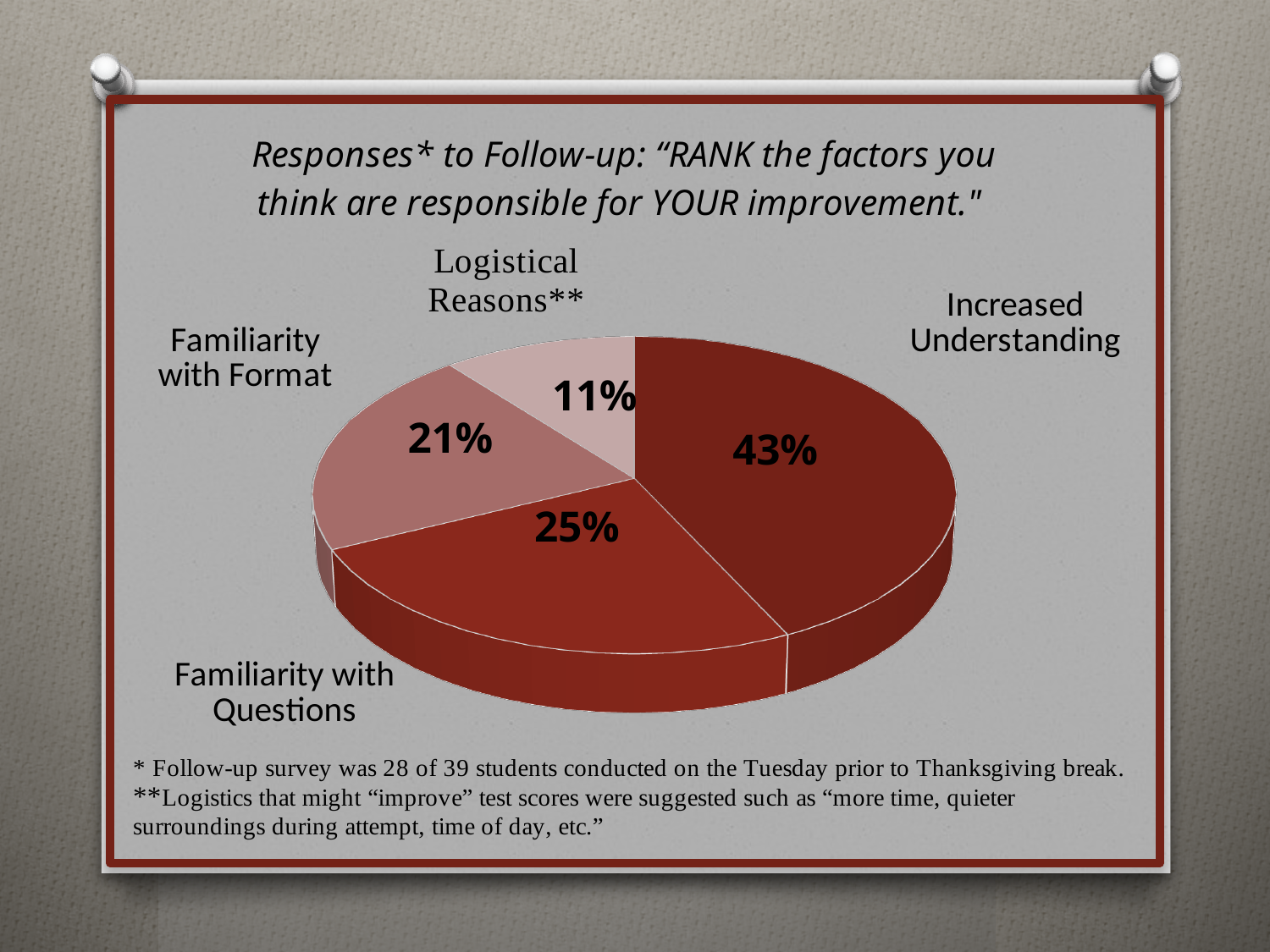
What share of responses is attributed to Familiarity with Questions? 25% What share of responses is attributed to Familiarity with Format? 21% Which factor has the largest slice of the pie? Increased Understanding What is the difference in percentage points between Familiarity with Format and Logistical Reasons? 10 What kind of chart is shown on the slide? Pie chart How many factors (slices) are shown in the pie chart? 4 What is the difference in percentage points between Increased Understanding and Familiarity with Questions? 18 Which is larger, the share for Familiarity with Questions or the share for Familiarity with Format? Familiarity with Questions What share of responses is attributed to Increased Understanding? 43% What share of responses is attributed to Logistical Reasons? 11% Which factor has the smallest slice of the pie? Logistical Reasons According to the footnote, how many of the 39 students completed the follow-up survey? 28